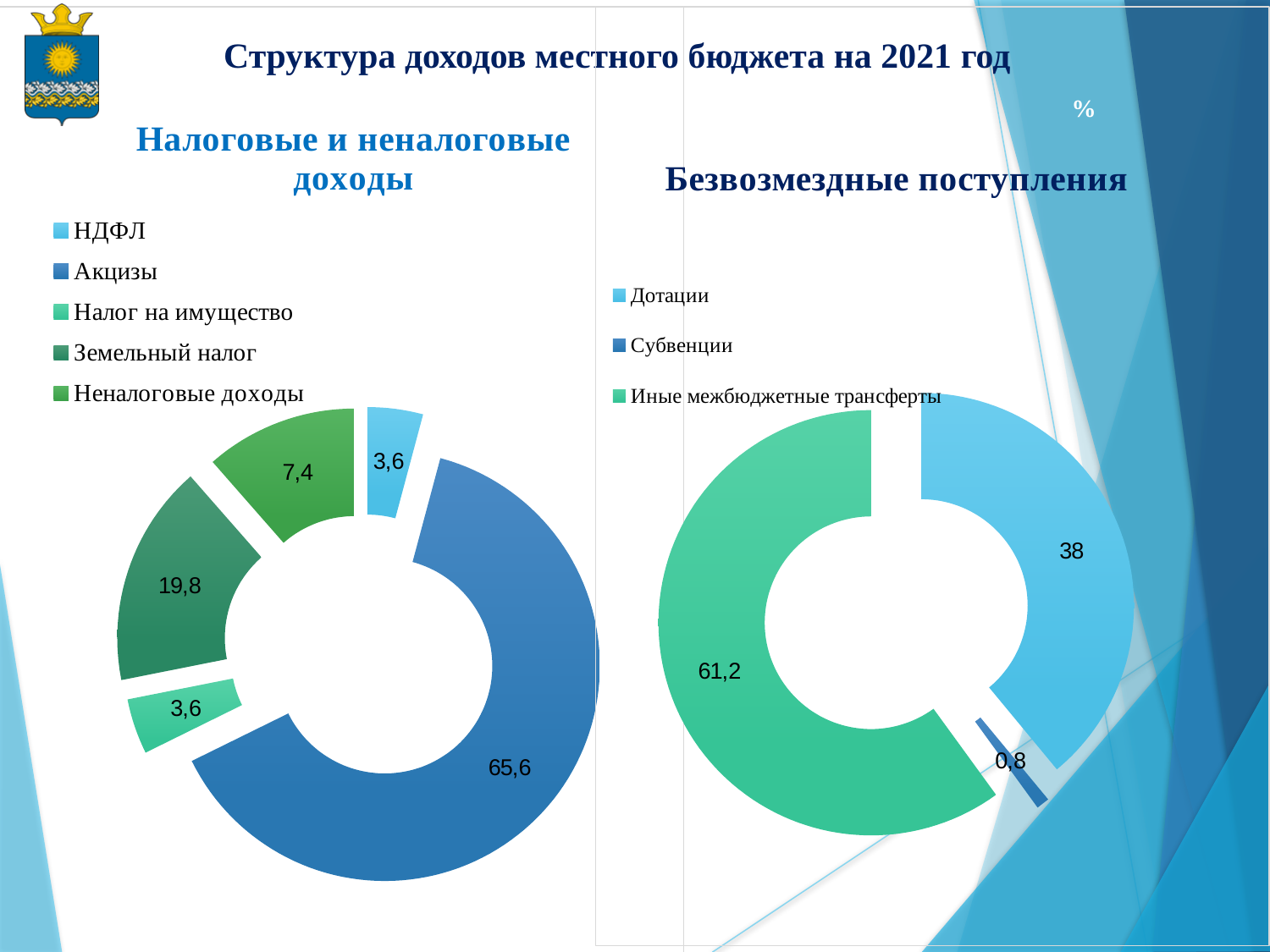
In the chart 'Налоговые и неналоговые доходы', how many categories are shown? 5 What type of chart is used for 'Безвозмездные поступления'? Doughnut chart In the chart 'Безвозмездные поступления', which is larger: Дотации or Иные межбюджетные трансферты? Иные межбюджетные трансферты In the chart 'Безвозмездные поступления', which category has the smallest share? Субвенции In the chart 'Налоговые и неналоговые доходы', which category has the largest share? Акцизы In the chart 'Налоговые и неналоговые доходы', what is the value for Акцизы? 65,6 In the chart 'Безвозмездные поступления', how many entries does the legend list? 3 In the chart 'Безвозмездные поступления', what is the value for Субвенции? 0,8 In the chart 'Налоговые и неналоговые доходы', what is the value for Неналоговые доходы? 7,4 In the chart 'Безвозмездные поступления', what is the value for Дотации? 38 In the chart 'Налоговые и неналоговые доходы', what is the value for Земельный налог? 19,8 In the chart 'Налоговые и неналоговые доходы', what is the difference between Земельный налог and Неналоговые доходы? 12,4